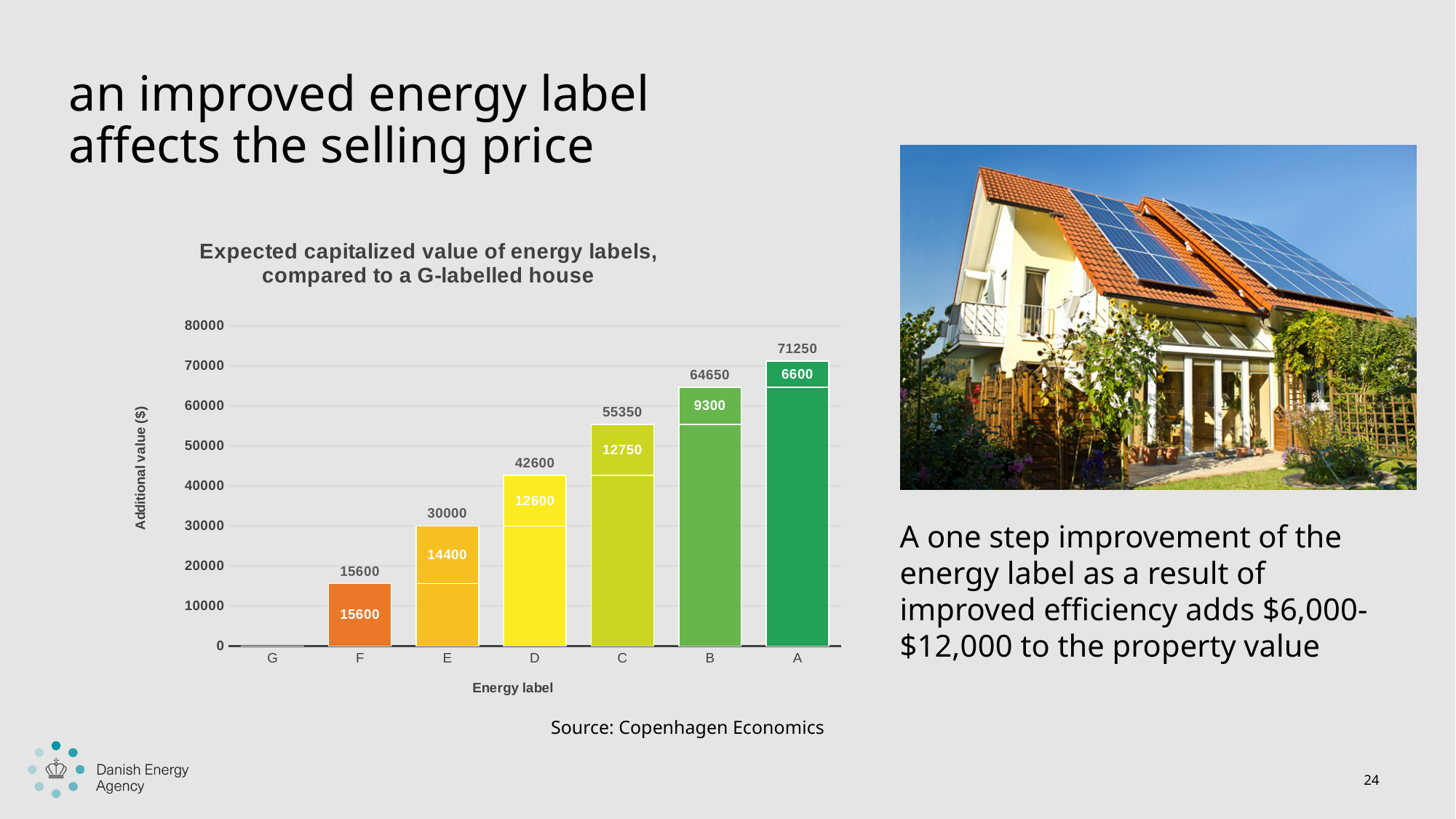
What is the value of the top segment of the bar for energy label C? 12750 Do the total values rise or fall moving from G to A along the x axis? Rise What is the total value printed above the bar for energy label D? 42600 Which energy label has the lowest total expected capitalized value? G Which has a larger total value, energy label C or energy label D? C What is the difference between the total values for energy labels A and B? 6600 Which energy label has the highest total expected capitalized value? A What is the value of the top segment of the bar for energy label B? 9300 What is the total expected capitalized value shown above the bar for energy label A? 71250 What is the difference between the total values for energy labels E and F? 14400 How many energy label categories are shown on the x axis? 7 What kind of chart is used to show the expected capitalized value of energy labels? Stacked bar chart